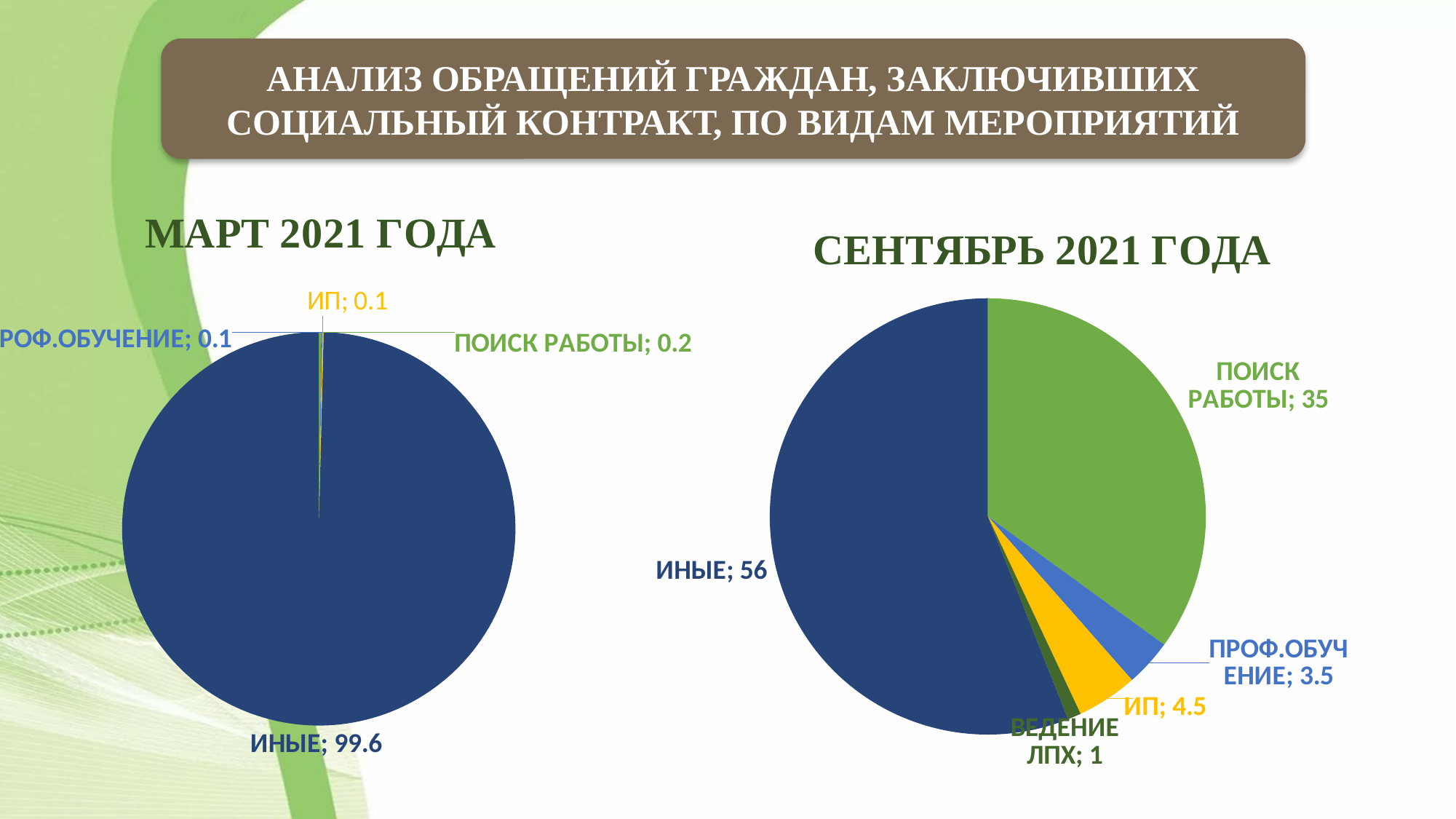
How many categories are shown in the СЕНТЯБРЬ 2021 ГОДА chart? 5 In the СЕНТЯБРЬ 2021 ГОДА chart, which category has the largest slice? ИНЫЕ In the СЕНТЯБРЬ 2021 ГОДА chart, which is larger: ИП or ПРОФ.ОБУЧЕНИЕ? ИП In the СЕНТЯБРЬ 2021 ГОДА chart, what is the difference between ИНЫЕ and ПОИСК РАБОТЫ? 21 In the МАРТ 2021 ГОДА chart, what is the value for ИНЫЕ? 99.6 In the МАРТ 2021 ГОДА chart, which category has the largest slice? ИНЫЕ In the МАРТ 2021 ГОДА chart, what is the value for ПОИСК РАБОТЫ? 0.2 In the СЕНТЯБРЬ 2021 ГОДА chart, which category has the smallest slice? ВЕДЕНИЕ ЛПХ In the СЕНТЯБРЬ 2021 ГОДА chart, what is the value for ИП? 4.5 What type of chart is used for МАРТ 2021 ГОДА? pie chart In the СЕНТЯБРЬ 2021 ГОДА chart, what is the value for ПОИСК РАБОТЫ? 35 In the СЕНТЯБРЬ 2021 ГОДА chart, what colour is the ИНЫЕ slice? dark blue